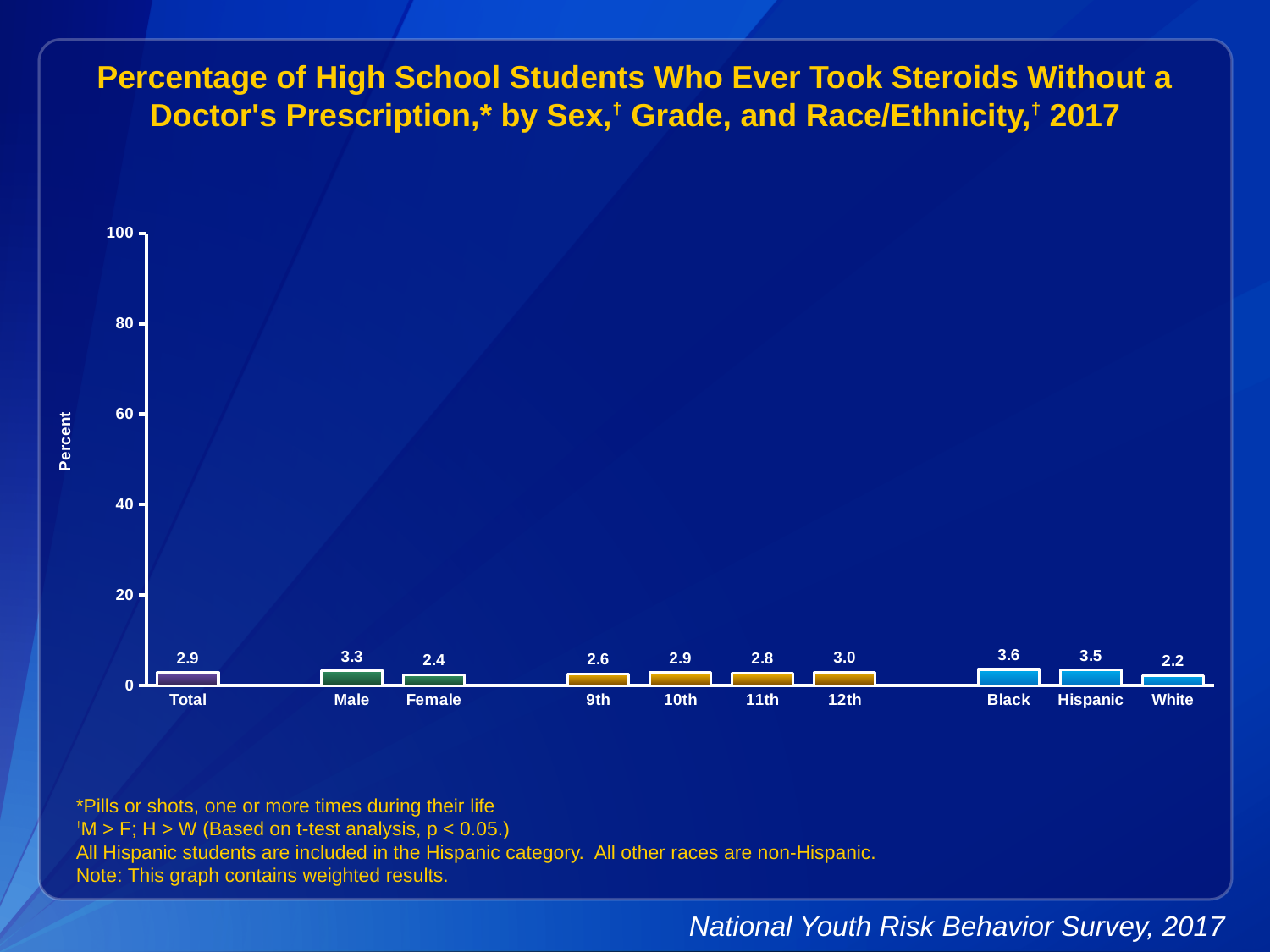
What is the difference between the values for Male and Female? 0.9 How many categories are shown on the x axis? 10 What is the value for White? 2.2 Which is larger, the value for Hispanic or the value for White? Hispanic What is the value for Male? 3.3 Is the value for Black greater or less than 20? less What is the value for Total? 2.9 What kind of chart is this? bar chart Which category has the highest value? Black What is the label on the y axis? Percent Which category has the lowest value? White What is the value for 12th grade? 3.0